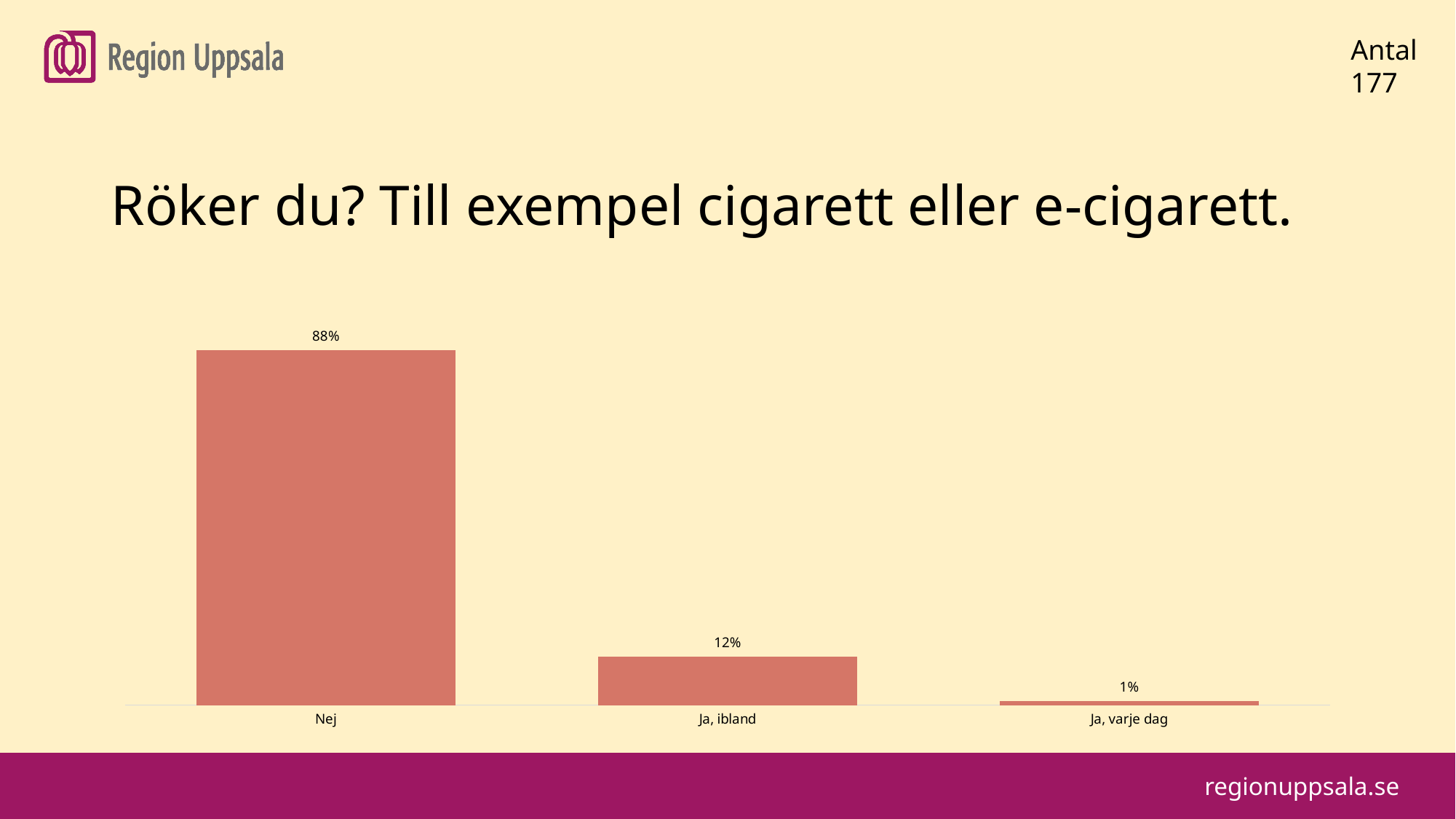
What is the value for "Ja, varje dag"? 1% Do the values rise or fall from left to right across the categories? Fall What is the difference between the values for "Ja, ibland" and "Ja, varje dag"? 11 percentage points What is the title of the chart on the slide? Röker du? Till exempel cigarett eller e-cigarett. How many categories are shown in the chart? 3 What is the value for "Ja, ibland"? 12% Which category has the highest value? Nej What is the difference between the values for "Nej" and "Ja, ibland"? 76 percentage points What kind of chart is shown on the slide? Bar chart Which category has the lowest value? Ja, varje dag Which is larger, the value for "Ja, ibland" or the value for "Ja, varje dag"? Ja, ibland What is the value for "Nej"? 88%